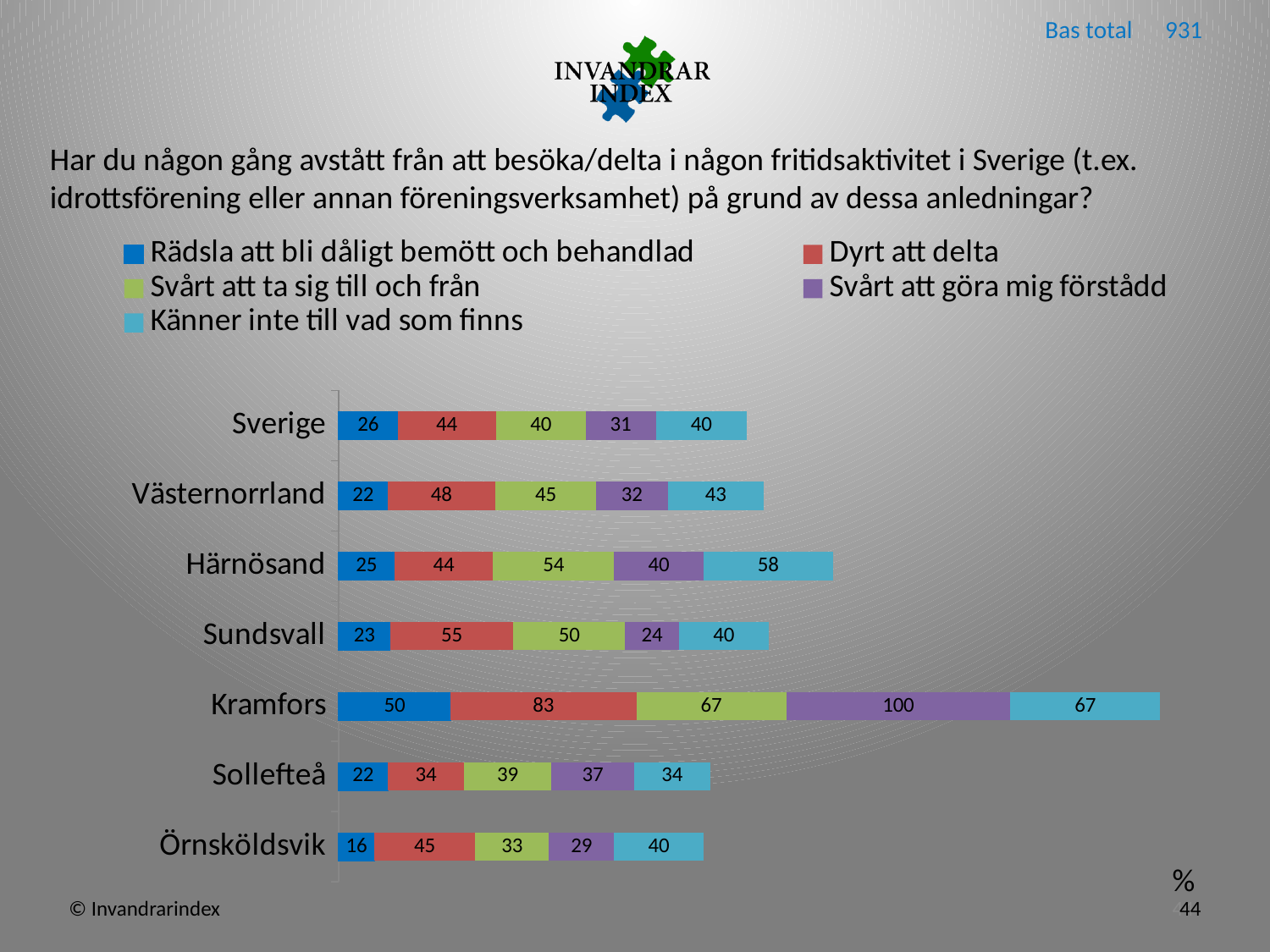
What is the value for "Svårt att göra mig förstådd" for Kramfors? 100 How many categories (regions) are plotted on the chart? 7 Which category has the highest value for "Svårt att ta sig till och från"? Kramfors Which category has the lowest value for "Rädsla att bli dåligt bemött och behandlad"? Örnsköldsvik What is the value for "Rädsla att bli dåligt bemött och behandlad" for Örnsköldsvik? 16 What kind of chart is shown on the slide? Stacked bar chart What is the value for "Känner inte till vad som finns" for Härnösand? 58 What is the value for "Dyrt att delta" for Sundsvall? 55 How many series does the legend list? 5 What is the total of the stacked bar for Sverige? 181 Which is larger: the "Svårt att ta sig till och från" value for Härnösand or for Västernorrland? Härnösand What is the difference between the "Dyrt att delta" values for Kramfors and Sollefteå? 49